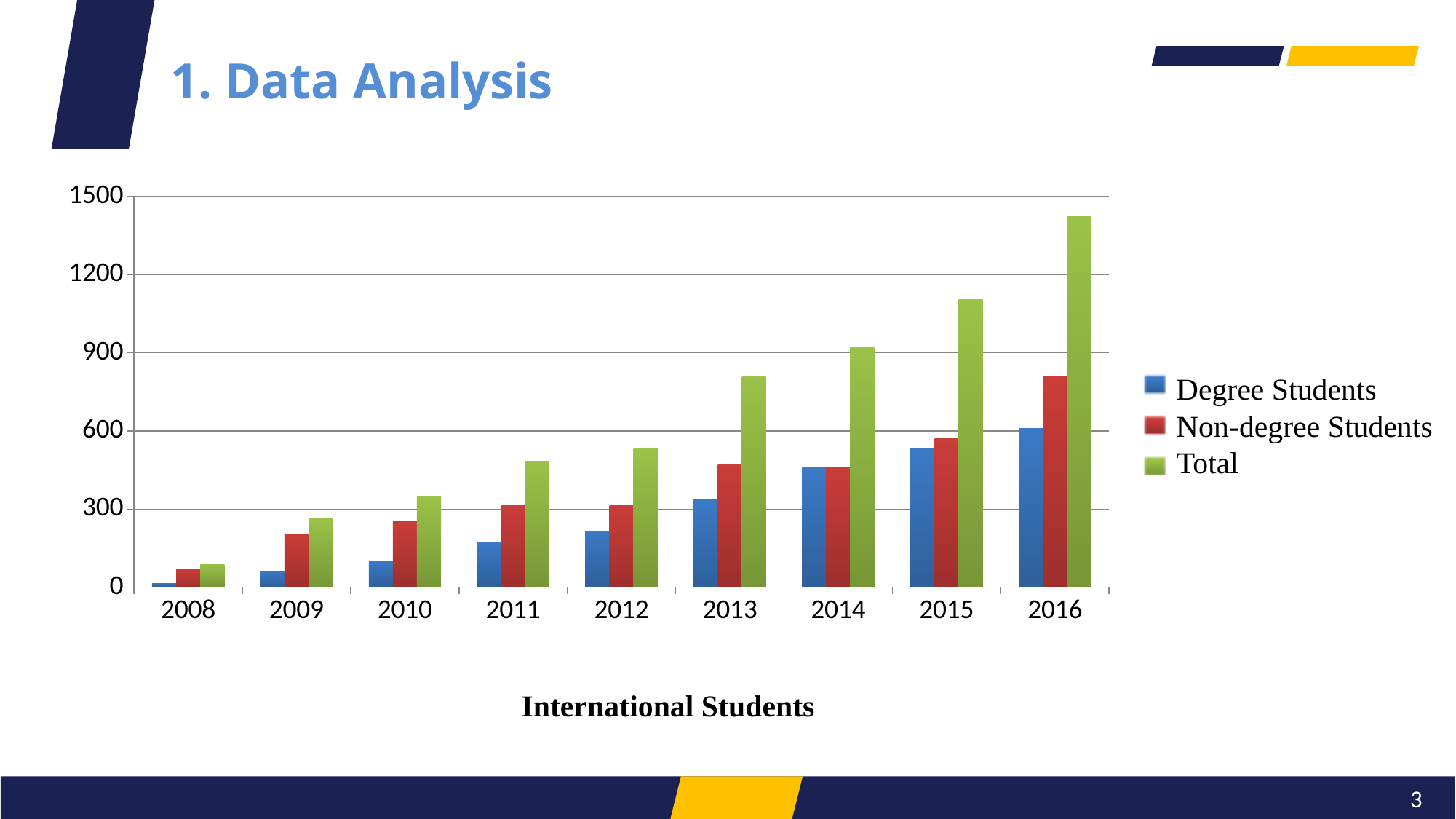
In which year is the Total bar lowest? 2008 In 2016, which is larger: Degree Students or Non-degree Students? Non-degree Students Do the Total values rise or fall from 2008 to 2016? rise Is the Degree Students value for 2013 greater or less than 300? greater Is the Total value for 2016 greater or less than 1200? greater What is the title shown below the chart's x axis? International Students How many series does the legend list? 3 Is the Non-degree Students value for 2016 greater or less than 900? less How many years are shown on the x axis? 9 In which year is the Total bar highest? 2016 What kind of chart is shown on the slide? bar chart